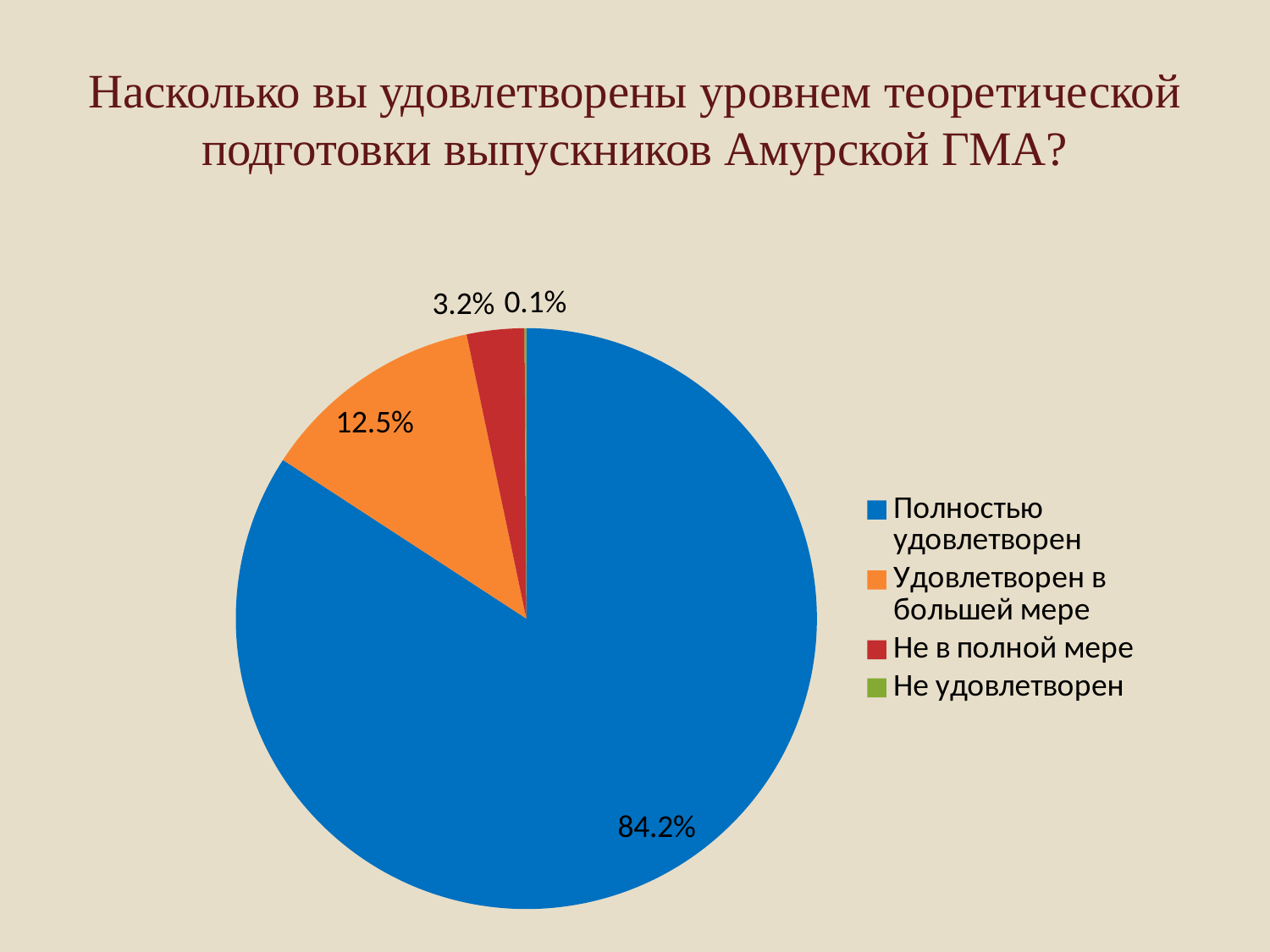
What kind of chart is shown on the slide? pie chart What colour is the slice for "Не в полной мере"? red What share of respondents answered "Не в полной мере"? 3.2% What share of respondents answered "Полностью удовлетворен"? 84.2% Which category has the largest slice of the pie? Полностью удовлетворен What is the title of the chart on the slide? Насколько вы удовлетворены уровнем теоретической подготовки выпускников Амурской ГМА? Which is larger: the share for "Удовлетворен в большей мере" or for "Не в полной мере"? Удовлетворен в большей мере What is the difference between the shares for "Полностью удовлетворен" and "Удовлетворен в большей мере"? 71.7% Which category has the smallest slice of the pie? Не удовлетворен What share of respondents answered "Не удовлетворен"? 0.1% What share of respondents answered "Удовлетворен в большей мере"? 12.5% How many categories does the legend list? 4